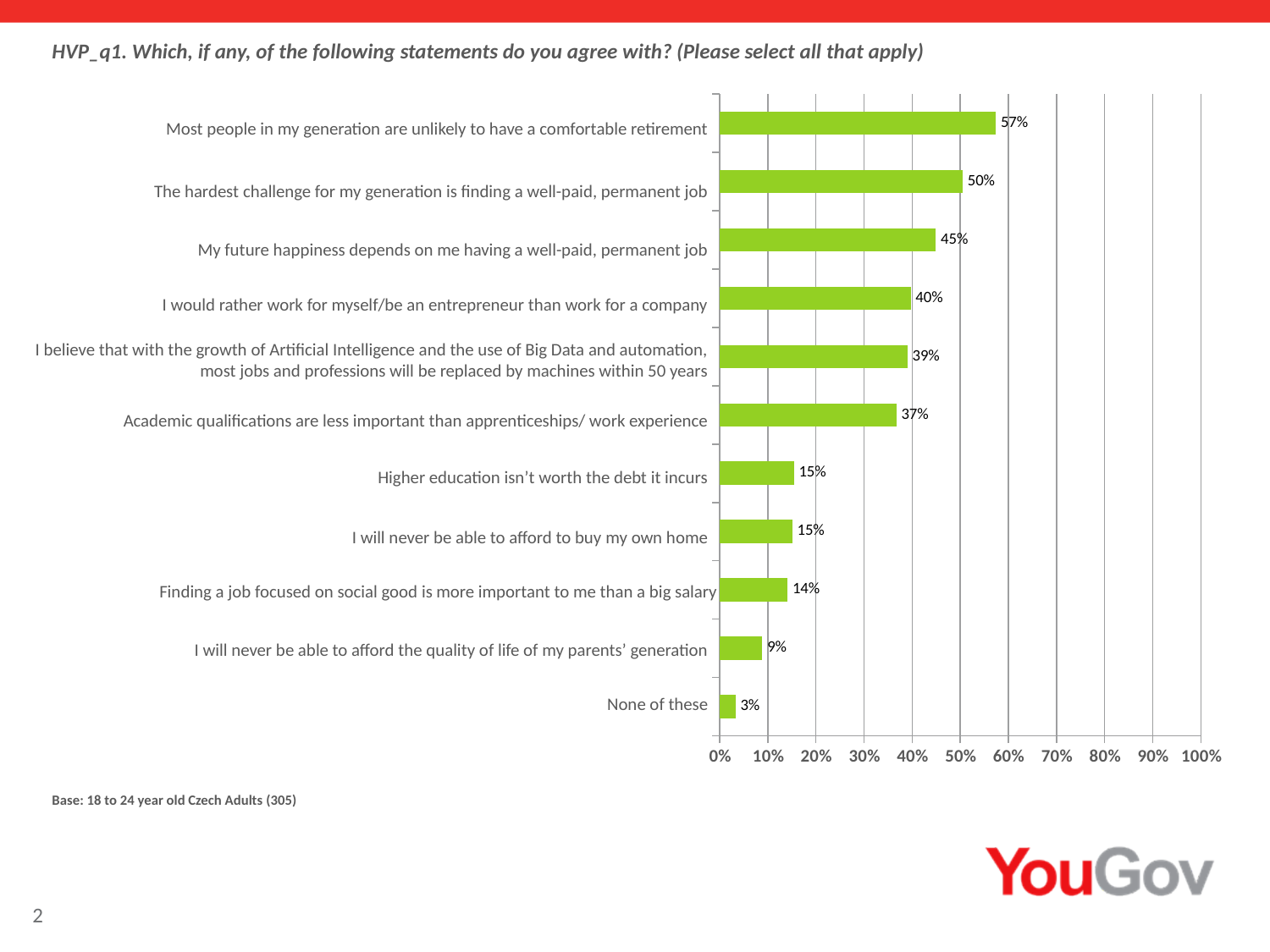
How many statements (categories) are shown on the chart? 11 Is the value for 'I believe that with the growth of Artificial Intelligence and the use of Big Data and automation, most jobs and professions will be replaced by machines within 50 years' greater or less than 30%? greater Which has a larger value: 'Finding a job focused on social good is more important to me than a big salary' or 'I will never be able to afford the quality of life of my parents' generation'? Finding a job focused on social good is more important to me than a big salary What percentage agreed that the hardest challenge for their generation is finding a well-paid, permanent job? 50% What type of chart is shown on the slide? Bar chart What is the difference between the value for 'My future happiness depends on me having a well-paid, permanent job' and the value for 'Academic qualifications are less important than apprenticeships/ work experience'? 8% What percentage selected 'None of these'? 3% What is the base described below the chart? 18 to 24 year old Czech Adults (305) Which category has the lowest value on the chart? None of these What percentage agreed with 'I would rather work for myself/be an entrepreneur than work for a company'? 40% What percentage agreed that most people in their generation are unlikely to have a comfortable retirement? 57% Which statement has the highest level of agreement? Most people in my generation are unlikely to have a comfortable retirement